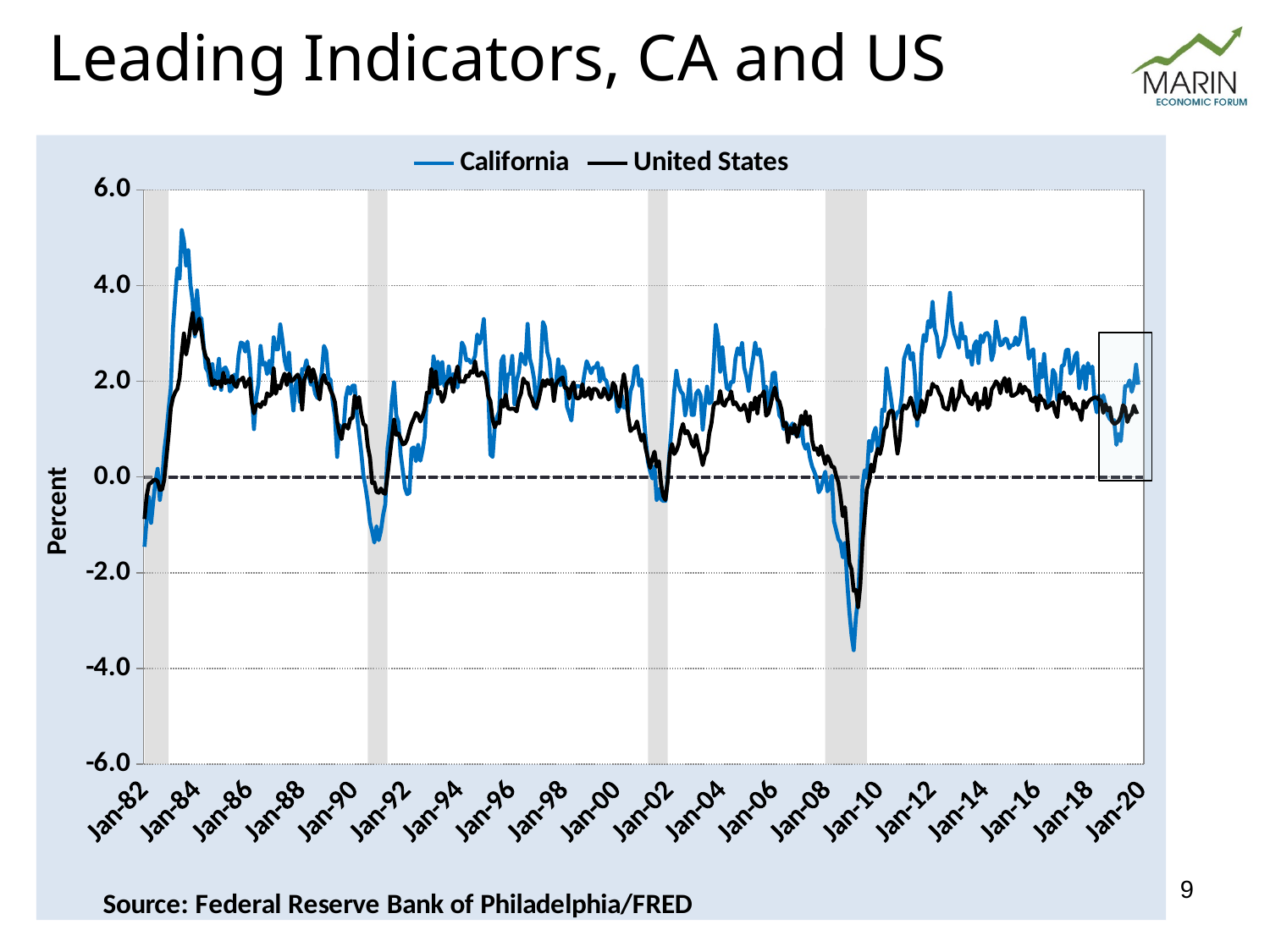
Which series reaches the higher peak value over the whole period, California or United States? California Around Jan-14, which series has the larger value, California or United States? California What kind of chart is shown on the slide? line chart Is the lowest value for California around Jan-09 greater or less than -2.0? less Do the values for both series rise or fall between Jan-08 and Jan-09? fall How many year labels are shown along the x axis? 20 What are the two series named in the legend? California and United States Which series falls to the lower value in the trough around Jan-09, California or United States? California What is the label on the vertical axis? Percent Is the lowest value for the United States around Jan-09 greater or less than -2.0? less Is the peak value for California around Jan-84 greater or less than 4.0? greater How many series does the legend list? 2